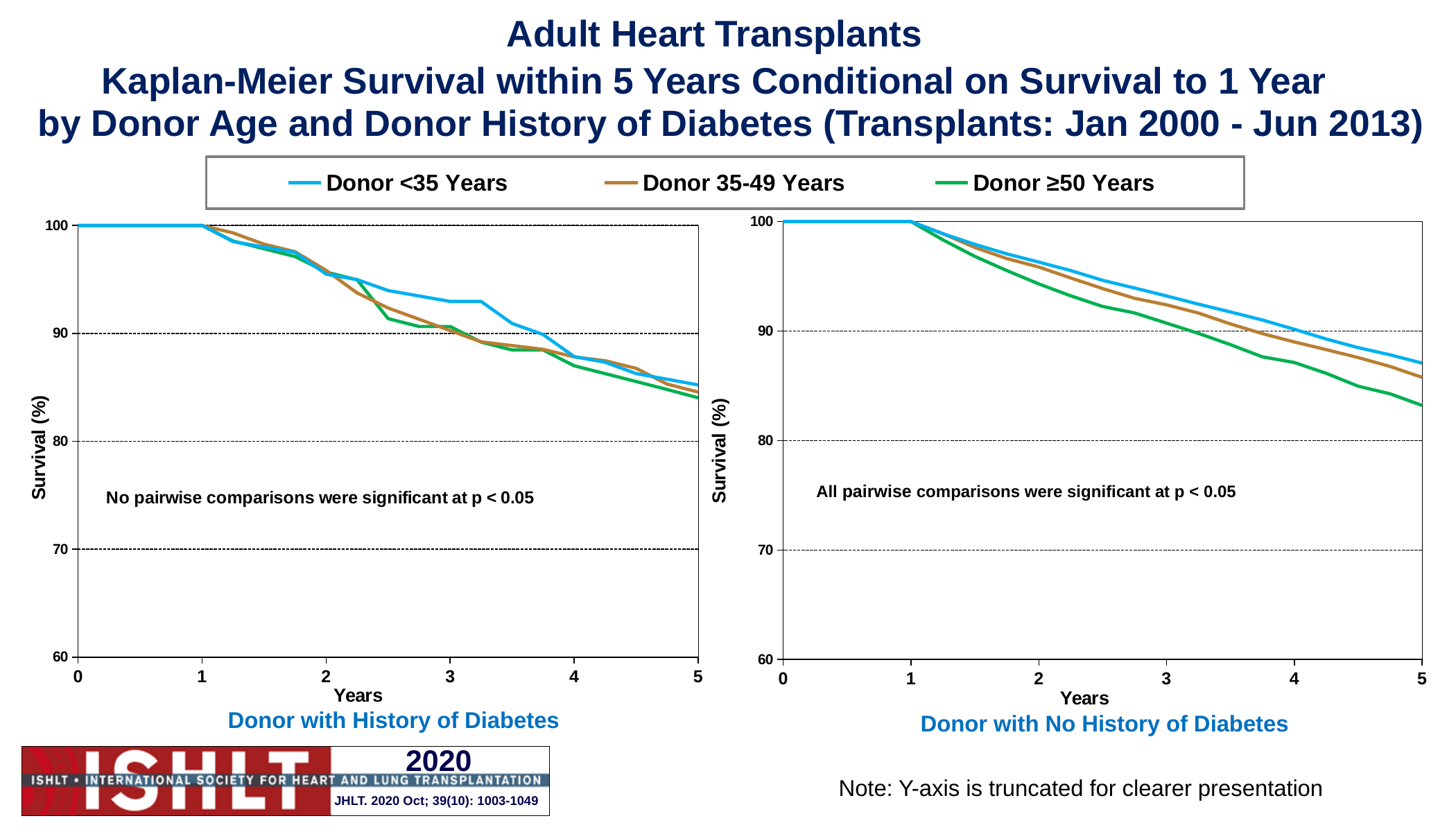
In the 'Donor with History of Diabetes' chart, which series has higher survival at 3 years: Donor <35 Years or Donor 35-49 Years? Donor <35 Years In the 'Donor with No History of Diabetes' chart, is the survival for Donor ≥50 Years at 5 years greater or less than 90? less In the 'Donor with No History of Diabetes' chart, which series has the lowest survival at 5 years? Donor ≥50 Years How many series does the legend list? 3 In the 'Donor with No History of Diabetes' chart, which series has higher survival at 5 years: Donor <35 Years or Donor ≥50 Years? Donor <35 Years In the 'Donor with History of Diabetes' chart, is the survival for Donor <35 Years at 3 years greater or less than 90? greater In the 'Donor with No History of Diabetes' chart, is the survival for Donor ≥50 Years at 5 years greater or less than 80? greater What is the y-axis label on the 'Donor with History of Diabetes' chart? Survival (%) What note is printed inside the 'Donor with No History of Diabetes' chart about pairwise comparisons? All pairwise comparisons were significant at p < 0.05 In the 'Donor with No History of Diabetes' chart, do the survival curves rise or fall as years increase? fall What kind of chart is the 'Donor with History of Diabetes' chart? line chart